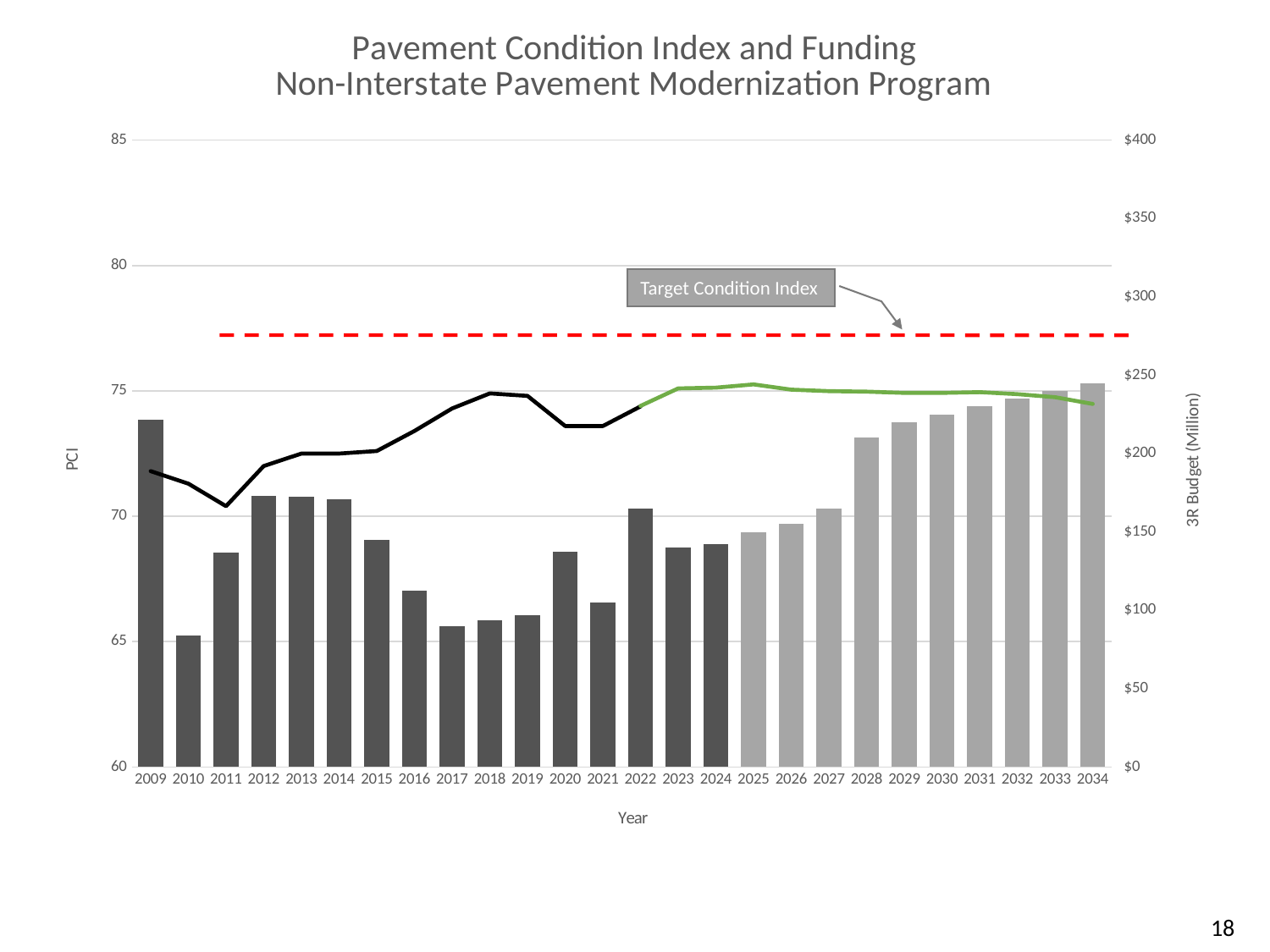
How many years are shown along the x axis? 26 What kind of chart is shown on the slide? Combination bar and line chart Is the Target Condition Index line greater or less than a PCI of 75? greater Is the 3R Budget bar for 2010 greater or less than $100 million? less Which year has a larger 3R Budget bar, 2009 or 2010? 2009 Which year has the shortest 3R Budget bar? 2010 What does the red dashed line on the chart represent? Target Condition Index Which year has the tallest 3R Budget bar? 2034 Do the 3R Budget bars rise or fall from 2025 to 2034? rise What is the title of the chart? Pavement Condition Index and Funding Non-Interstate Pavement Modernization Program Is the 3R Budget bar for 2028 greater or less than $200 million? greater